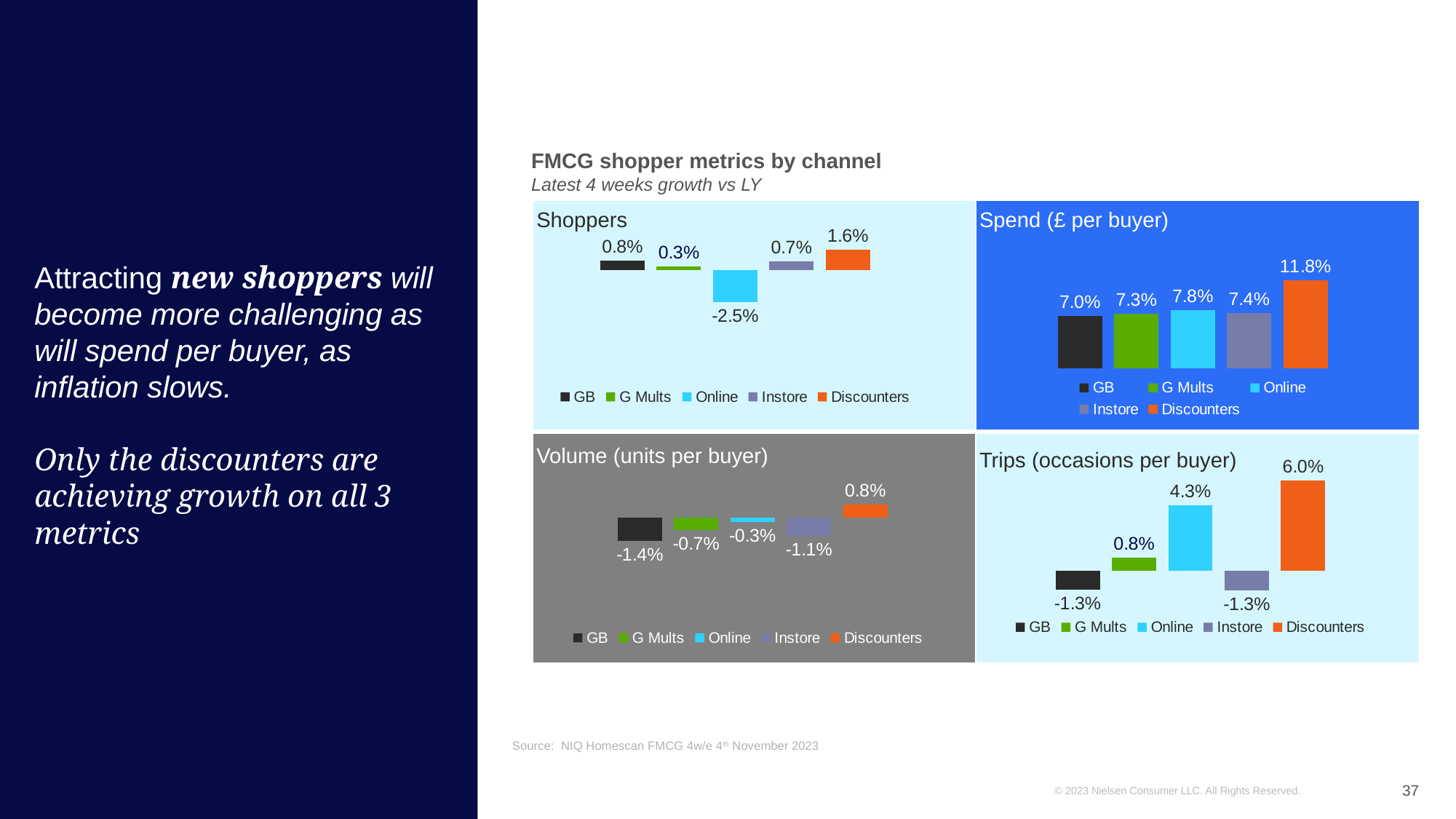
What kind of chart is the Spend (£ per buyer) chart? Bar chart In the Shoppers chart, what is the difference between the Discounters value and the GB value? 0.8% In the Volume (units per buyer) chart, what is the value for GB? -1.4% In the Volume (units per buyer) chart, which is larger, the value for G Mults or the value for Instore? G Mults In the Trips (occasions per buyer) chart, which channel has the highest value? Discounters In the Spend (£ per buyer) chart, what is the value for Discounters? 11.8% What is the subtitle shown under the heading 'FMCG shopper metrics by channel'? Latest 4 weeks growth vs LY In the Spend (£ per buyer) chart, what is the difference between the Online value and the G Mults value? 0.5% In the Trips (occasions per buyer) chart, what is the value for Online? 4.3% How many series does the legend of the Shoppers chart list? 5 In the Shoppers chart, what is the value for Online? -2.5% In the Spend (£ per buyer) chart, which channel has the lowest value? GB